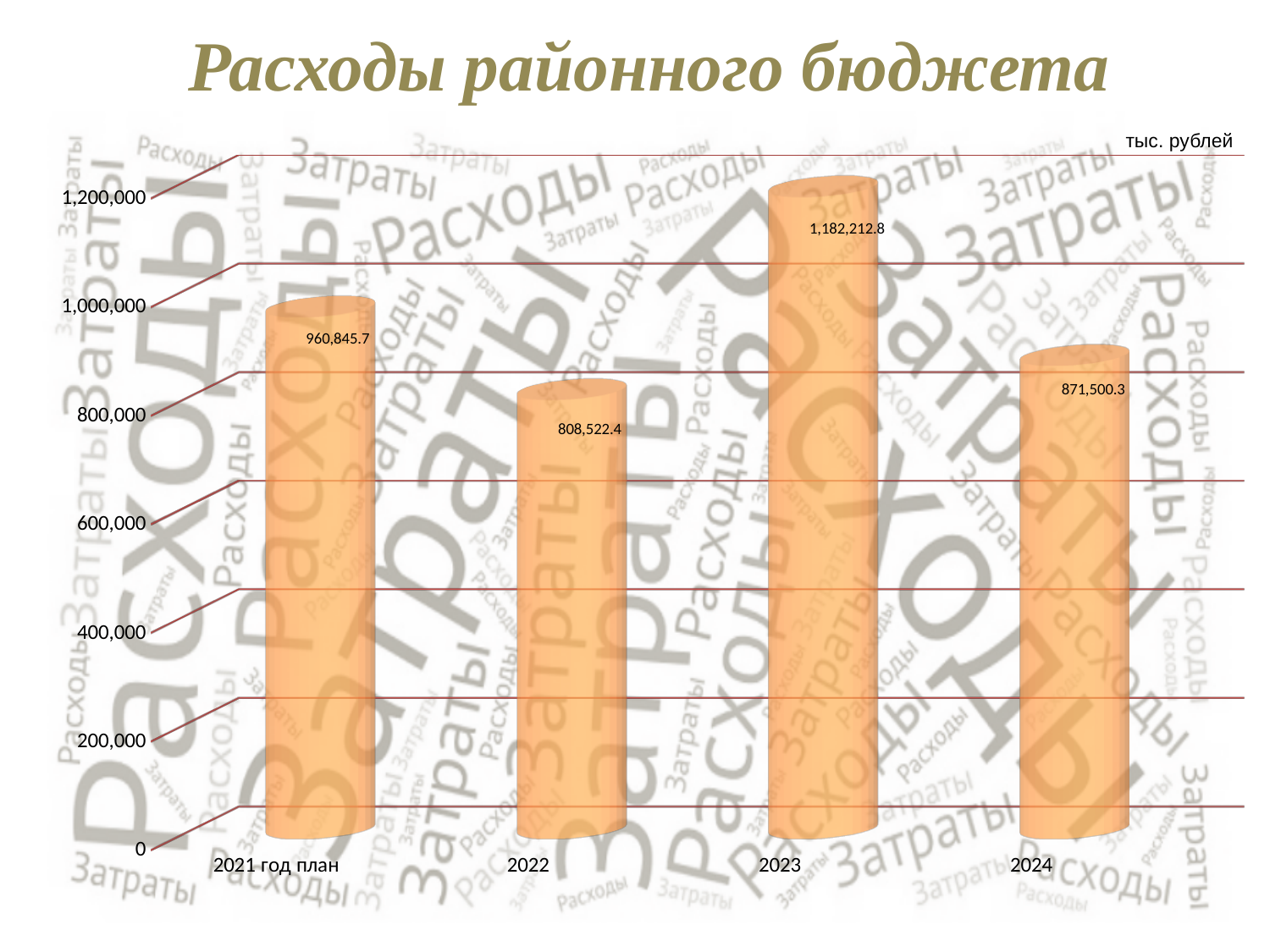
Is the value for 2022 greater or less than 1,000,000? less Which year has the lowest value? 2022 How many categories are shown on the x axis? 4 Which is larger, the value for 2021 год план or the value for 2024? 2021 год план Which year has the highest value? 2023 What is the value for 2023? 1,182,212.8 What is the value for 2024? 871,500.3 What kind of chart is shown on the slide? bar chart What is the difference between the values for 2024 and 2022? 62,977.9 What is the value for 2021 год план? 960,845.7 What is the title of the chart? Расходы районного бюджета What is the difference between the values for 2023 and 2021 год план? 221,367.1